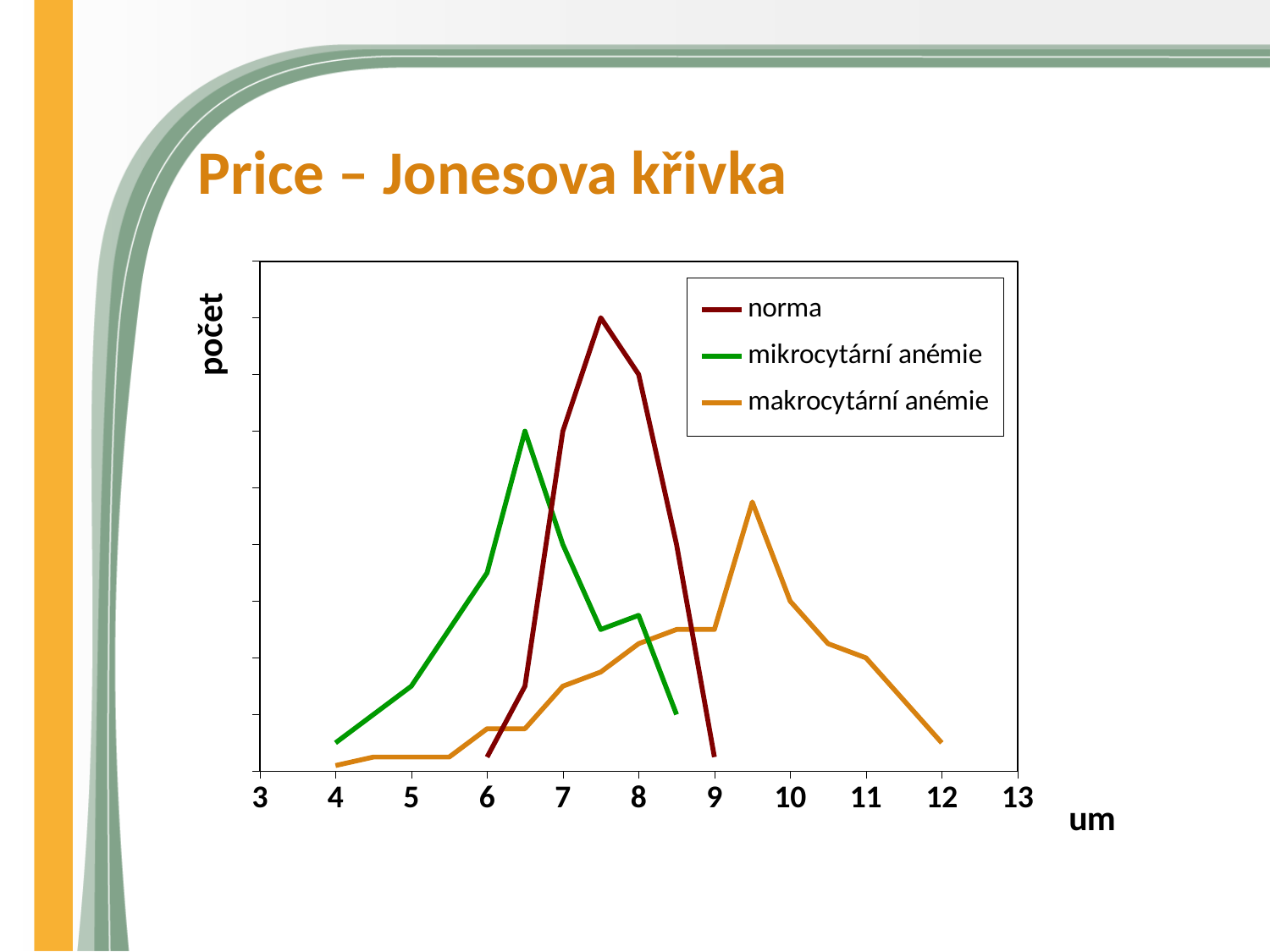
Does the norma series rise or fall between x = 7.5 and x = 9? fall Which series has the lowest peak on the chart? makrocytární anémie Which series reaches the highest peak on the chart? norma What is the label of the vertical axis? počet What kind of chart is shown on the slide? line chart How many series does the legend list? 3 At x = 6.5, which series has the larger value: norma or mikrocytární anémie? mikrocytární anémie At x = 10, which series has the larger value: makrocytární anémie or norma? makrocytární anémie What are the three series named in the legend? norma, mikrocytární anémie, makrocytární anémie